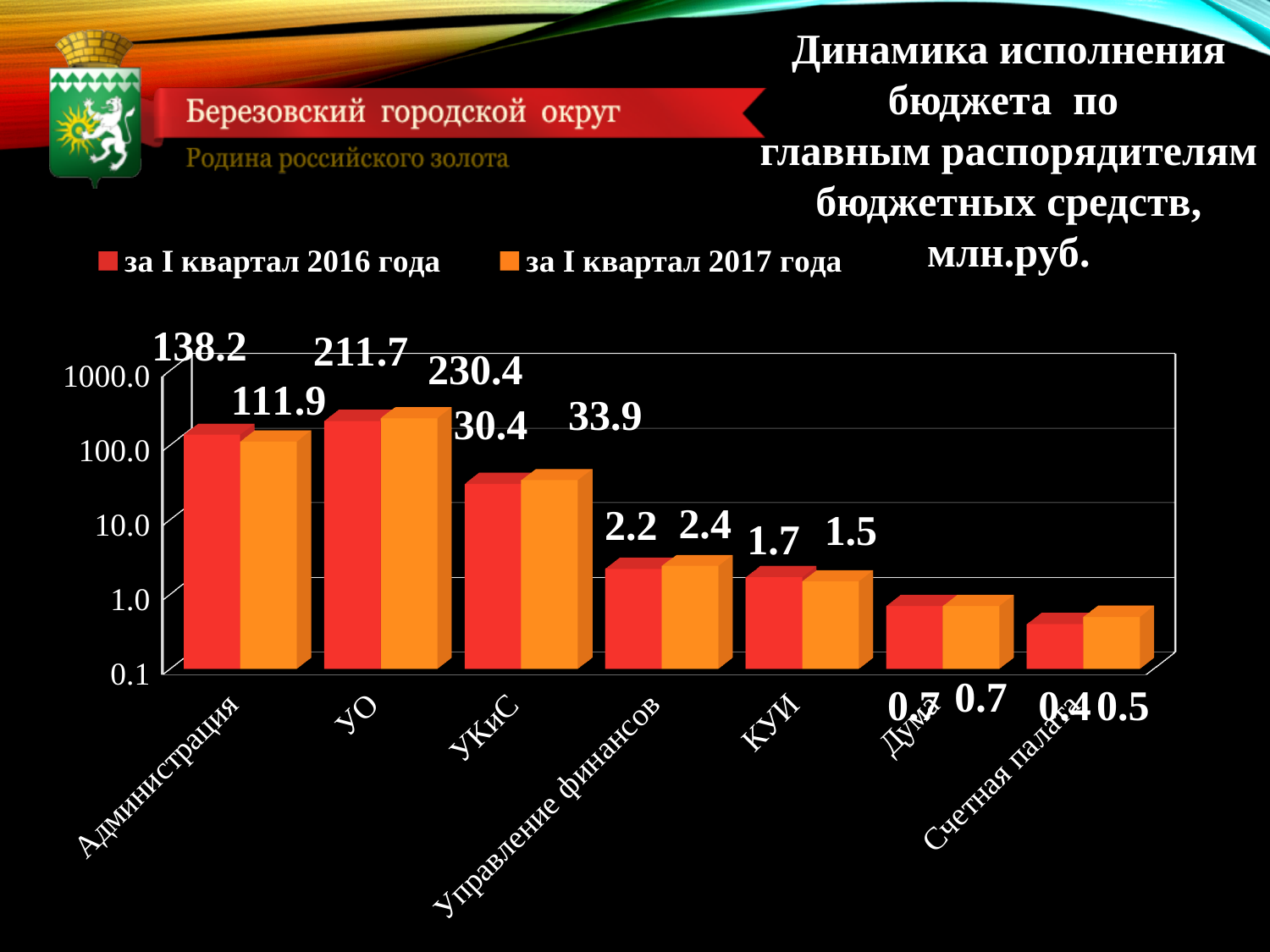
Which category has the lowest value for за I квартал 2016 года? Счетная палата What is the value for Администрация for за I квартал 2016 года? 138.2 How many series does the legend list? 2 What is the difference between the за I квартал 2016 года and за I квартал 2017 года values for Администрация? 26.3 Is the value for Управление финансов for за I квартал 2017 года greater or less than 10.0? less What is the value for УКиС for за I квартал 2017 года? 33.9 How many categories are shown on the x axis? 7 For УО, which is larger: the value for за I квартал 2016 года or за I квартал 2017 года? за I квартал 2017 года What is the value for КУИ for за I квартал 2016 года? 1.7 What is the value for УО for за I квартал 2017 года? 230.4 What kind of chart is shown on the slide? bar chart Which category has the highest value for за I квартал 2017 года? УО